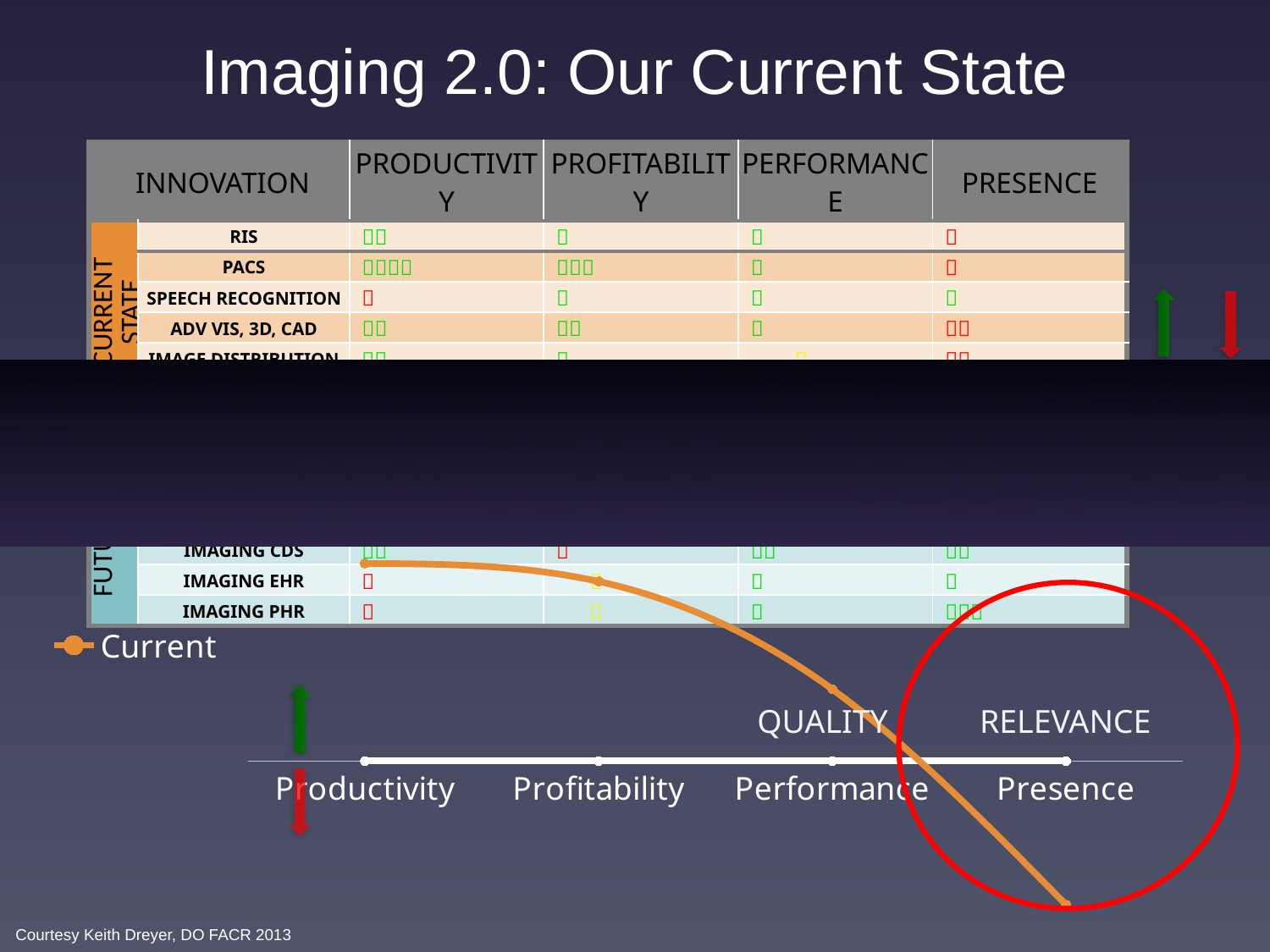
On the Current line, is the value for Productivity or Presence larger? Productivity Which category has the highest value on the Current line? Productivity How many series does the legend of the line chart list? 1 What is the first category label on the x axis of the line chart? Productivity What kind of chart is shown at the bottom of the slide? line chart What is the name of the series shown in the legend of the line chart? Current Which category has the lowest value on the Current line? Presence Do the values of the Current line rise or fall from Productivity to Presence? fall On the Current line, is the value for Profitability or Performance larger? Profitability What is the last category label on the x axis of the line chart? Presence How many categories are plotted along the x axis of the line chart? 4